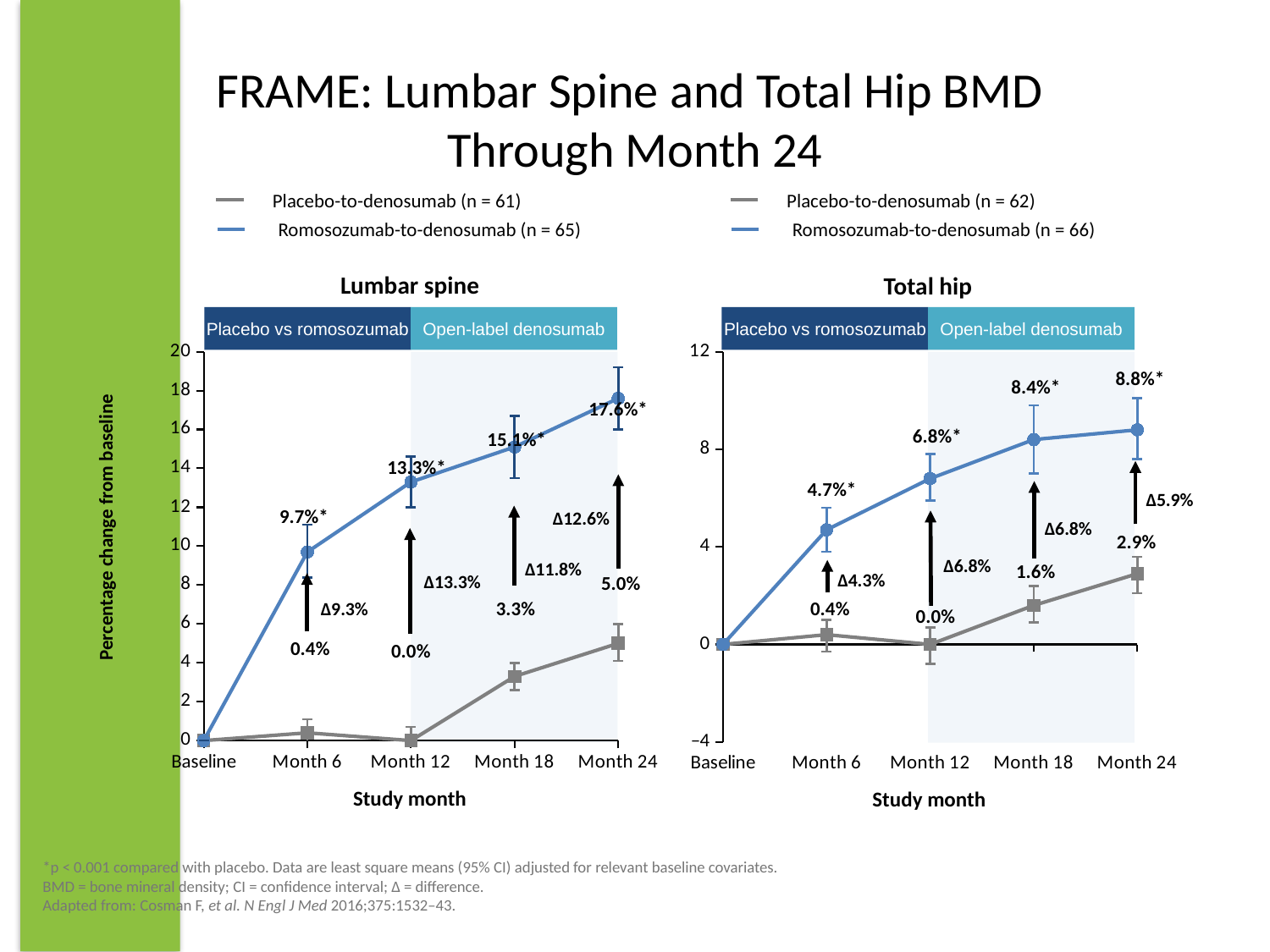
In the Total hip chart, what is the difference between the Romosozumab-to-denosumab and Placebo-to-denosumab values at Month 24? 5.9% What type of chart is the Total hip chart? Line chart How many series does the legend for the Lumbar spine chart list? 2 In the Total hip chart, at which study month is the Placebo-to-denosumab value lowest (excluding Baseline)? Month 12 In the Lumbar spine chart, what is the percentage change from baseline for Romosozumab-to-denosumab at Month 24? 17.6% In the Total hip chart, which series has the larger value at Month 18, Romosozumab-to-denosumab or Placebo-to-denosumab? Romosozumab-to-denosumab In the Lumbar spine chart, what is the percentage change from baseline for Placebo-to-denosumab at Month 18? 3.3% In the Lumbar spine chart, what is the difference between the Romosozumab-to-denosumab and Placebo-to-denosumab values at Month 6? 9.3% In the Total hip chart, what is the percentage change from baseline for Romosozumab-to-denosumab at Month 12? 6.8% In the Lumbar spine chart, does the Romosozumab-to-denosumab series rise or fall from Baseline to Month 24? Rise In the Lumbar spine chart, at which study month does the Romosozumab-to-denosumab series reach its highest value? Month 24 In the Total hip chart, what is the percentage change from baseline for Placebo-to-denosumab at Month 24? 2.9%